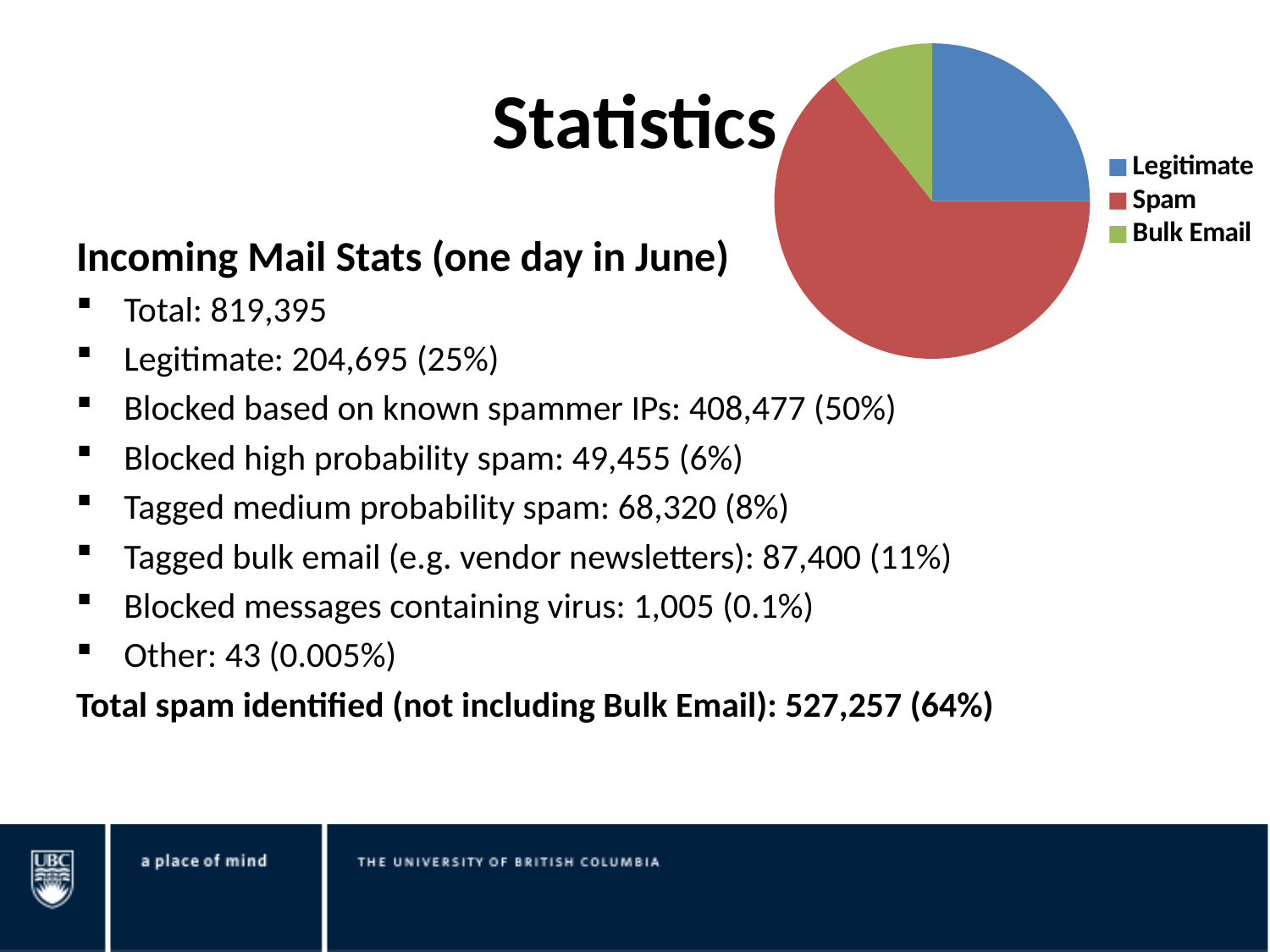
What kind of chart is shown on the slide? pie chart How many entries does the pie chart's legend list? 3 What colour is the Spam slice in the pie chart? red Is the Spam slice's share of the pie greater or less than 50%? greater In the pie chart, which slice is larger, Legitimate or Bulk Email? Legitimate In the pie chart, which slice is larger, Spam or Legitimate? Spam Which category has the largest slice in the pie chart? Spam Which category has the smallest slice in the pie chart? Bulk Email Is the Legitimate slice's share of the pie greater or less than 50%? less Which category is shown in green in the pie chart? Bulk Email How many slices does the pie chart have? 3